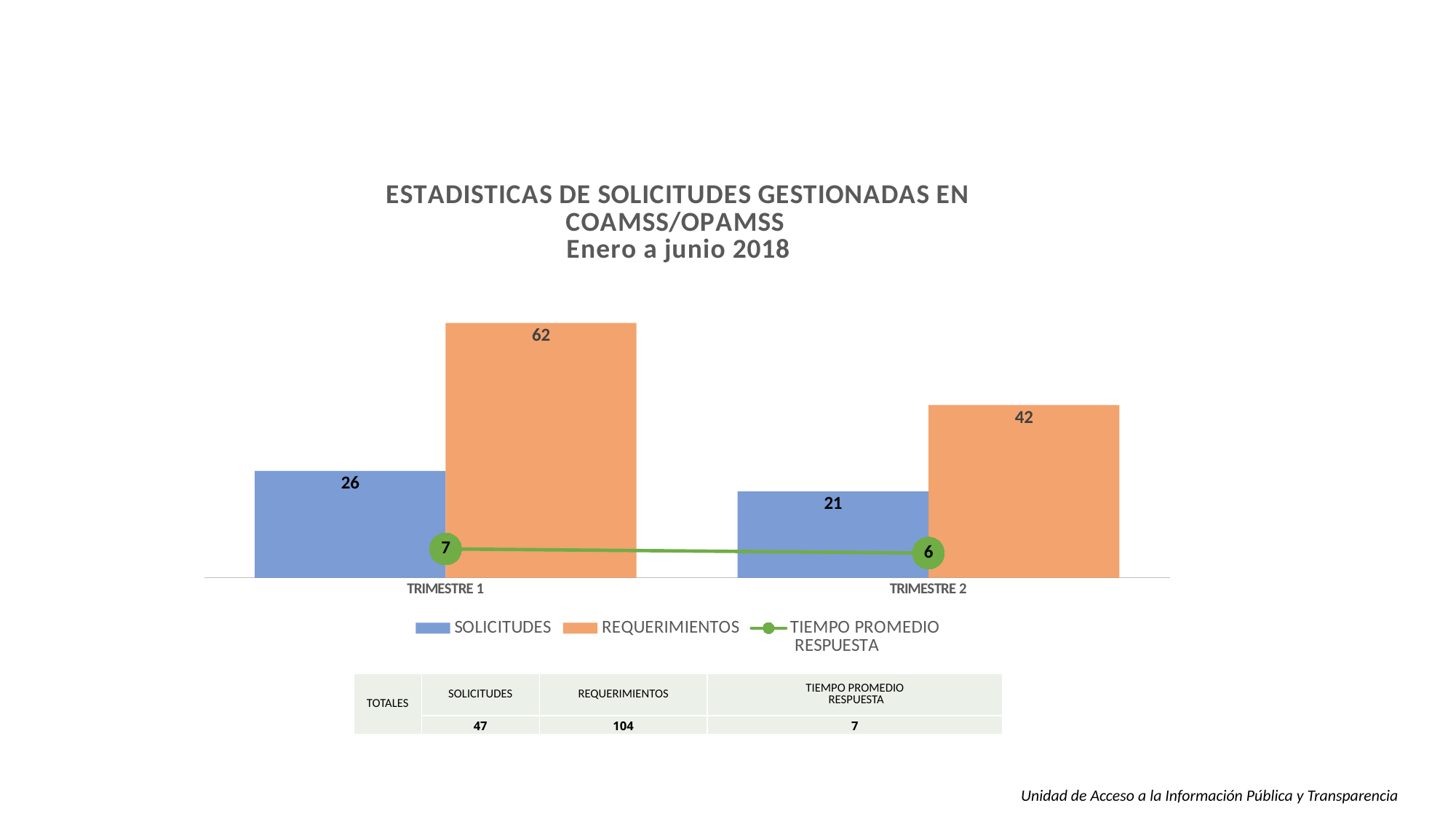
What colour are the REQUERIMIENTOS bars? orange What is the TIEMPO PROMEDIO RESPUESTA value for TRIMESTRE 1? 7 How many trimestre categories are shown on the x axis? 2 Which trimestre has the lowest SOLICITUDES value? TRIMESTRE 2 How many series does the legend list? 3 What is the difference between REQUERIMIENTOS in TRIMESTRE 1 and TRIMESTRE 2? 20 Which is larger in TRIMESTRE 2: SOLICITUDES or REQUERIMIENTOS? REQUERIMIENTOS Which trimestre has the highest REQUERIMIENTOS value? TRIMESTRE 1 What is the value of REQUERIMIENTOS for TRIMESTRE 2? 42 What is the value of SOLICITUDES for TRIMESTRE 1? 26 What is the value of SOLICITUDES for TRIMESTRE 2? 21 Does the TIEMPO PROMEDIO RESPUESTA line rise or fall from TRIMESTRE 1 to TRIMESTRE 2? fall